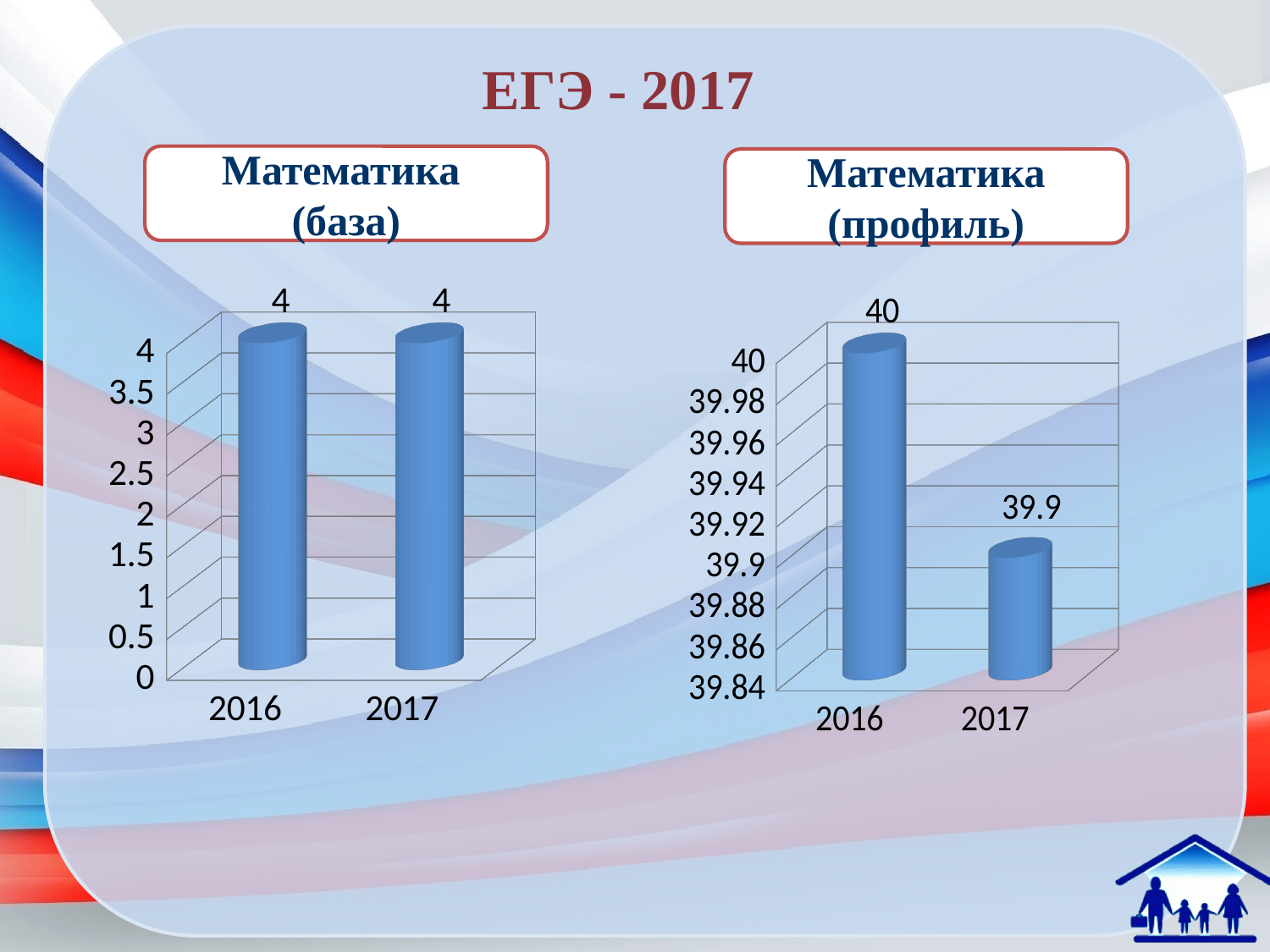
In the Математика (профиль) chart, which year has the lowest value? 2017 In the Математика (профиль) chart, which year has the highest value? 2016 What kind of chart is the Математика (профиль) chart? bar chart In the Математика (профиль) chart, do the values rise or fall from 2016 to 2017? fall In the Математика (профиль) chart, what is the value for 2016? 40 In the Математика (профиль) chart, what is the difference between the 2016 and 2017 values? 0.1 In the Математика (профиль) chart, is the value for 2016 larger or smaller than the value for 2017? larger What is the title of the slide above the two charts? ЕГЭ - 2017 In the Математика (профиль) chart, what is the value for 2017? 39.9 In the Математика (база) chart, what is the value for 2016? 4 In the Математика (база) chart, what is the value for 2017? 4 In the Математика (база) chart, how many years are shown on the x axis? 2